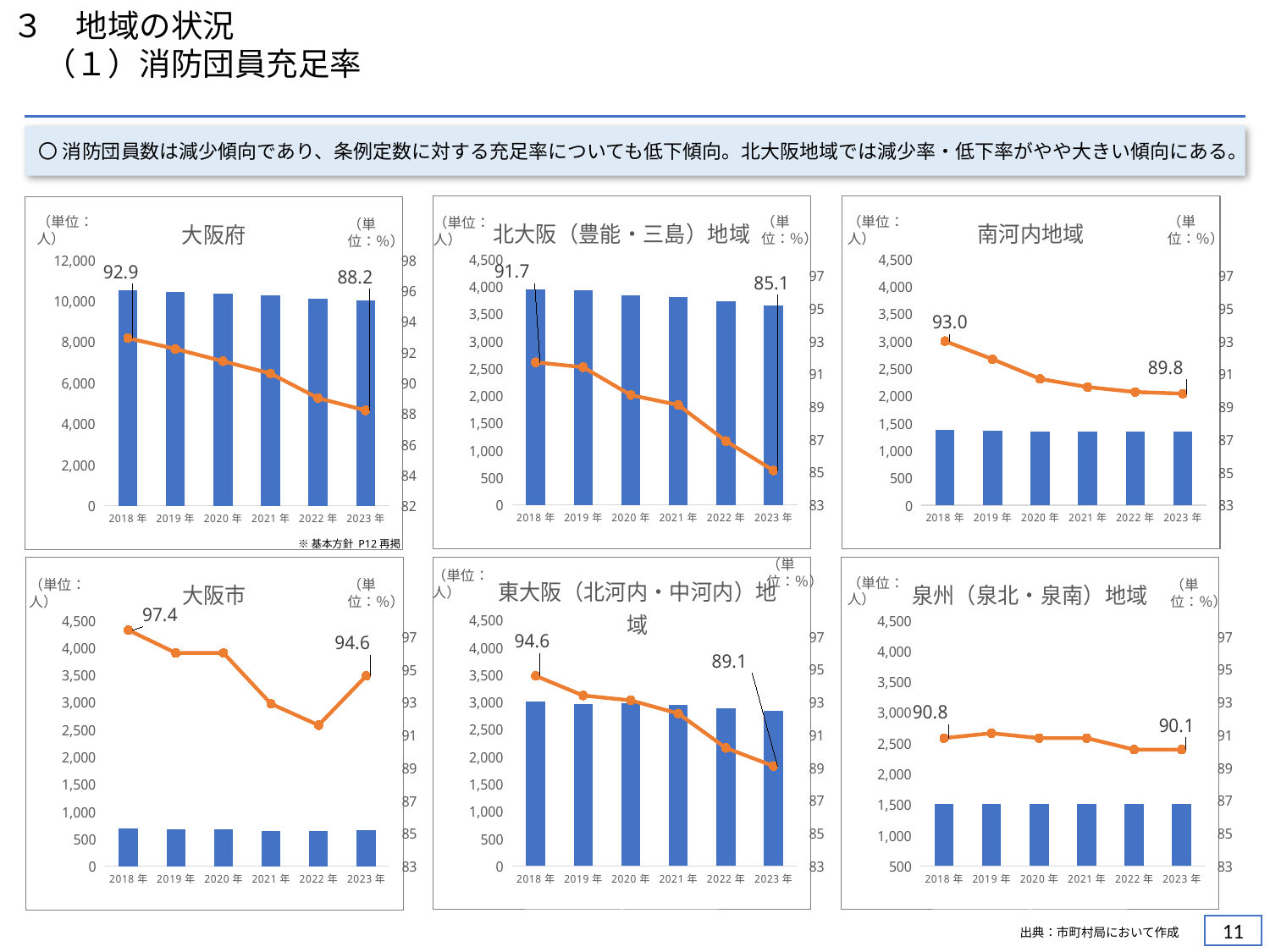
In the 大阪府 chart, what is the labelled fulfillment rate (%) for 2023年? 88.2 In the 東大阪（北河内・中河内）地域 chart, what is the difference between the 2018年 rate (94.6) and the 2023年 rate (89.1)? 5.5 In the 大阪府 chart, does the orange line rise or fall from 2018年 to 2023年? fall In the 大阪市 chart, what is the labelled rate for 2018年? 97.4 In the 大阪市 chart, is the bar value for 2018年 greater or less than 1,000? less In the 北大阪（豊能・三島）地域 chart, what is the labelled rate for 2023年? 85.1 In the 大阪府 chart, how many years are shown on the x axis? 6 In the 泉州（泉北・泉南）地域 chart, what is the labelled rate for 2023年? 90.1 In the 南河内地域 chart, what is the labelled rate for 2018年? 93.0 In the 大阪府 chart, what is the labelled fulfillment rate (%) for 2018年? 92.9 Which is larger: the 2018年 rate in the 大阪市 chart or the 2018年 rate in the 泉州（泉北・泉南）地域 chart? 大阪市 In the 大阪府 chart, by how many percentage points did the labelled rate fall from 2018年 (92.9) to 2023年 (88.2)? 4.7